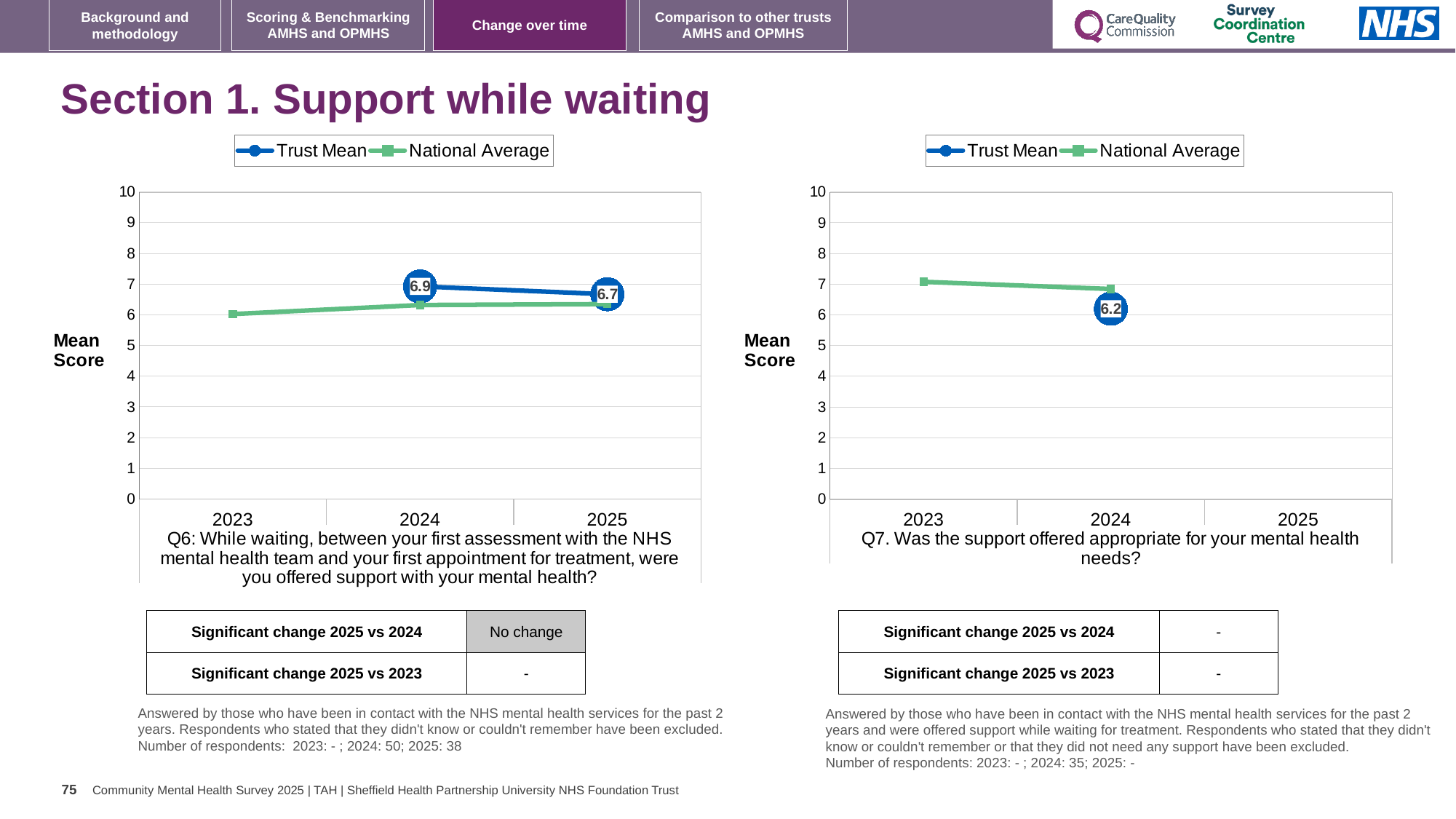
In the left chart (Q6), what is the difference between the Trust Mean values for 2024 and 2025? 0.2 How many series does the legend of the right chart (Q7) list? 2 In the right chart (Q7), which series has the higher value in 2024, Trust Mean or National Average? National Average In the right chart (Q7), what is the Trust Mean value for 2024? 6.2 In the left chart (Q6), what is the Trust Mean value for 2024? 6.9 In the left chart (Q6), what is the Trust Mean value for 2025? 6.7 In the right chart (Q7), is the National Average value for 2023 greater or less than 8? less In the left chart (Q6), which year has the higher Trust Mean, 2024 or 2025? 2024 In the left chart (Q6), does the Trust Mean rise or fall from 2024 to 2025? Fall In the left chart (Q6), which series has the higher value in 2024, Trust Mean or National Average? Trust Mean In the left chart (Q6), is the National Average value for 2023 greater or less than 5? greater What type of chart is the left chart (Q6)? Line chart